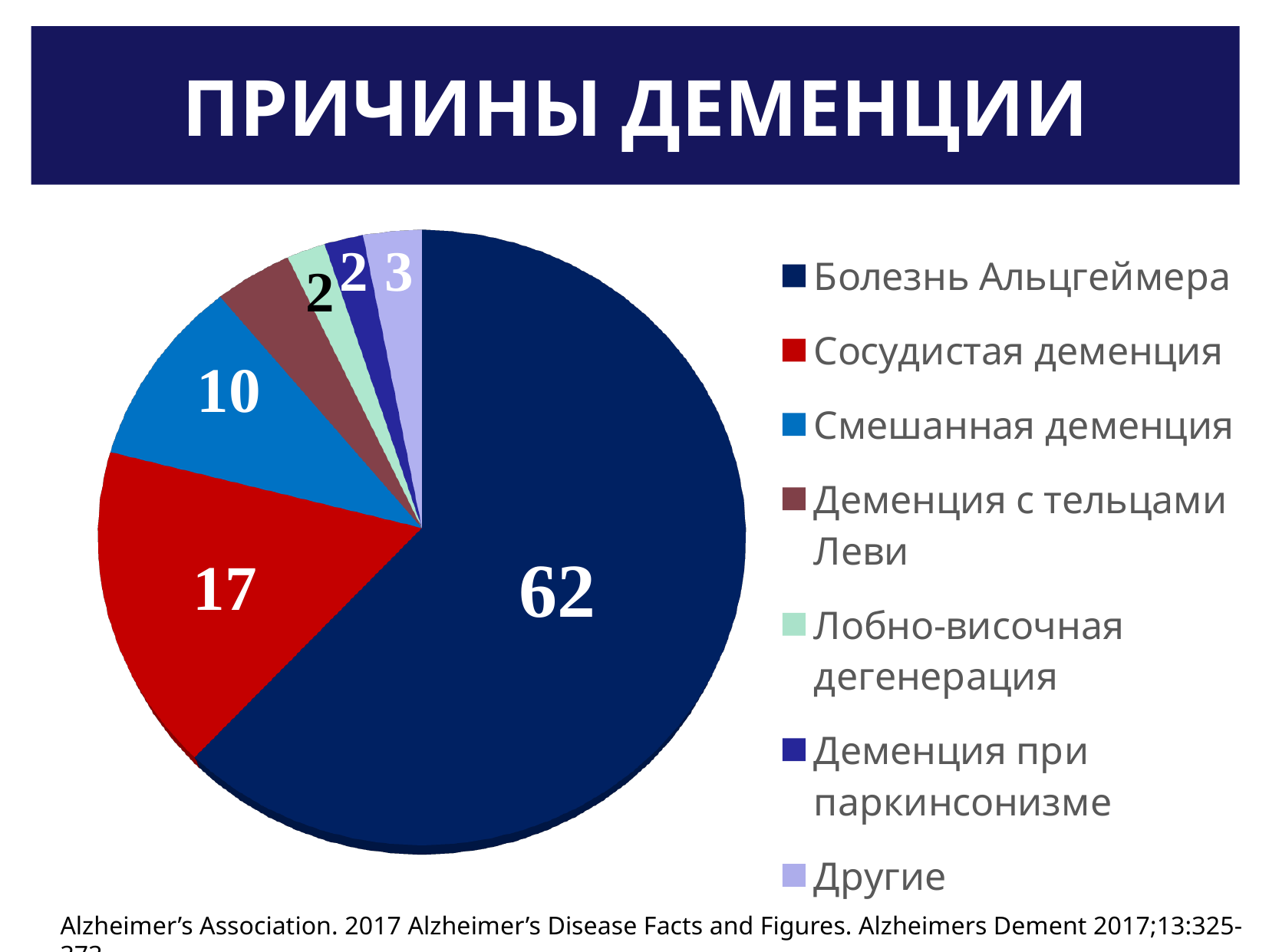
Which category has the largest slice in the pie chart? Болезнь Альцгеймера What is the value for Сосудистая деменция in the pie chart? 17 What is the difference between the values for Сосудистая деменция and Смешанная деменция? 7 What is the value for Смешанная деменция in the pie chart? 10 How many categories does the pie chart have? 7 What kind of chart is shown on the slide? pie chart Which is larger: the slice for Смешанная деменция or the slice for Другие? Смешанная деменция What is the value for Другие in the pie chart? 3 What is the value for Болезнь Альцгеймера in the pie chart? 62 What is the difference between the values for Болезнь Альцгеймера and Сосудистая деменция? 45 Which is larger: the slice for Сосудистая деменция or the slice for Смешанная деменция? Сосудистая деменция What is the title of the slide containing the pie chart? ПРИЧИНЫ ДЕМЕНЦИИ